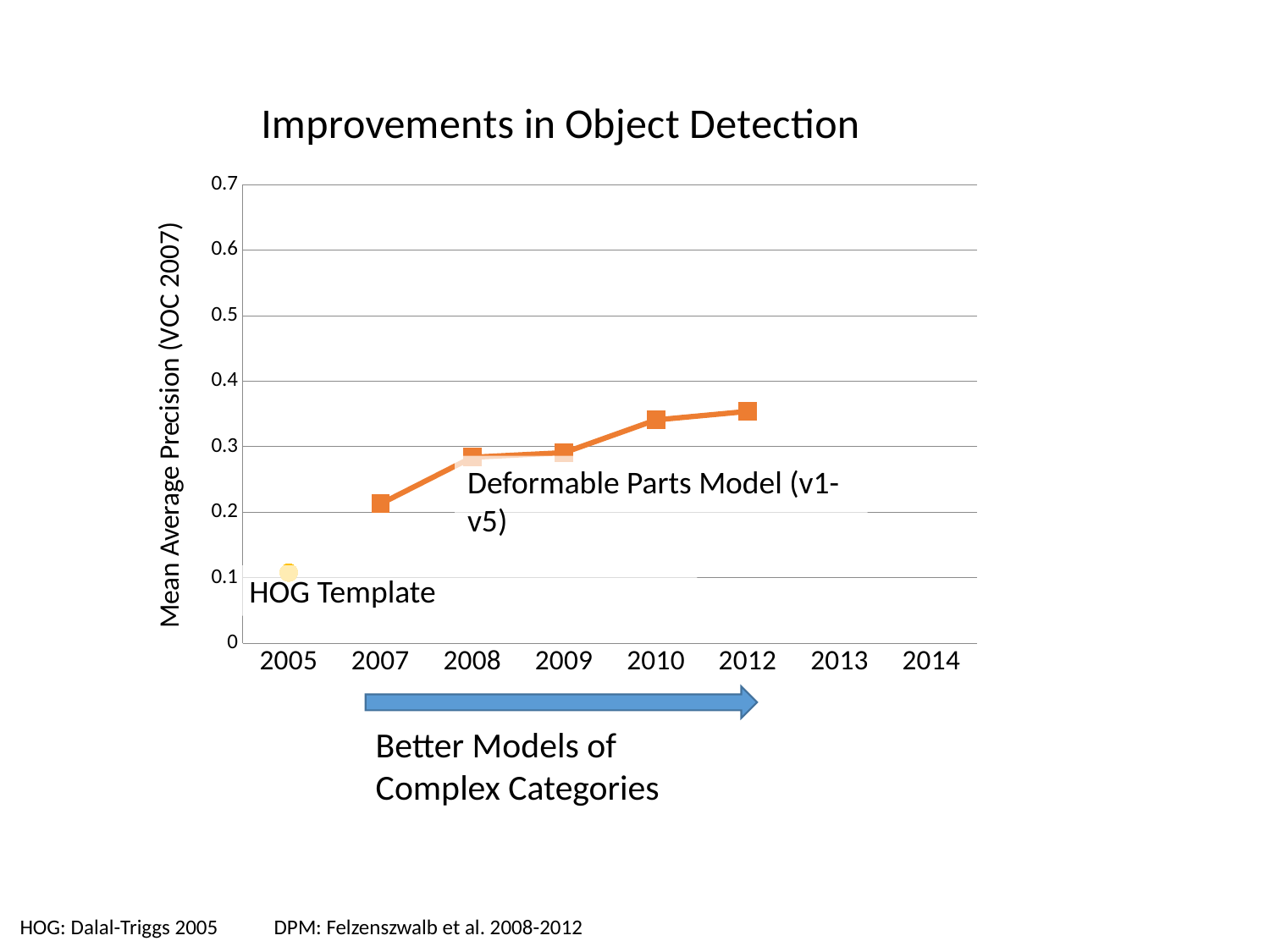
How many year labels are shown on the x axis? 8 Which year has the lowest value on the Deformable Parts Model (v1-v5) line? 2007 How many data points does the Deformable Parts Model (v1-v5) line have? 5 What kind of chart is shown on the slide? line chart Is the Deformable Parts Model value for 2007 greater or less than 0.3? less What is the label of the y axis? Mean Average Precision (VOC 2007) Does the Deformable Parts Model (v1-v5) line rise or fall from 2007 to 2012? rise What is the title of the chart? Improvements in Object Detection Is the HOG Template value for 2005 greater or less than 0.2? less Which is larger, the Deformable Parts Model value for 2007 or for 2010? 2010 Is the Deformable Parts Model value for 2012 greater or less than 0.4? less